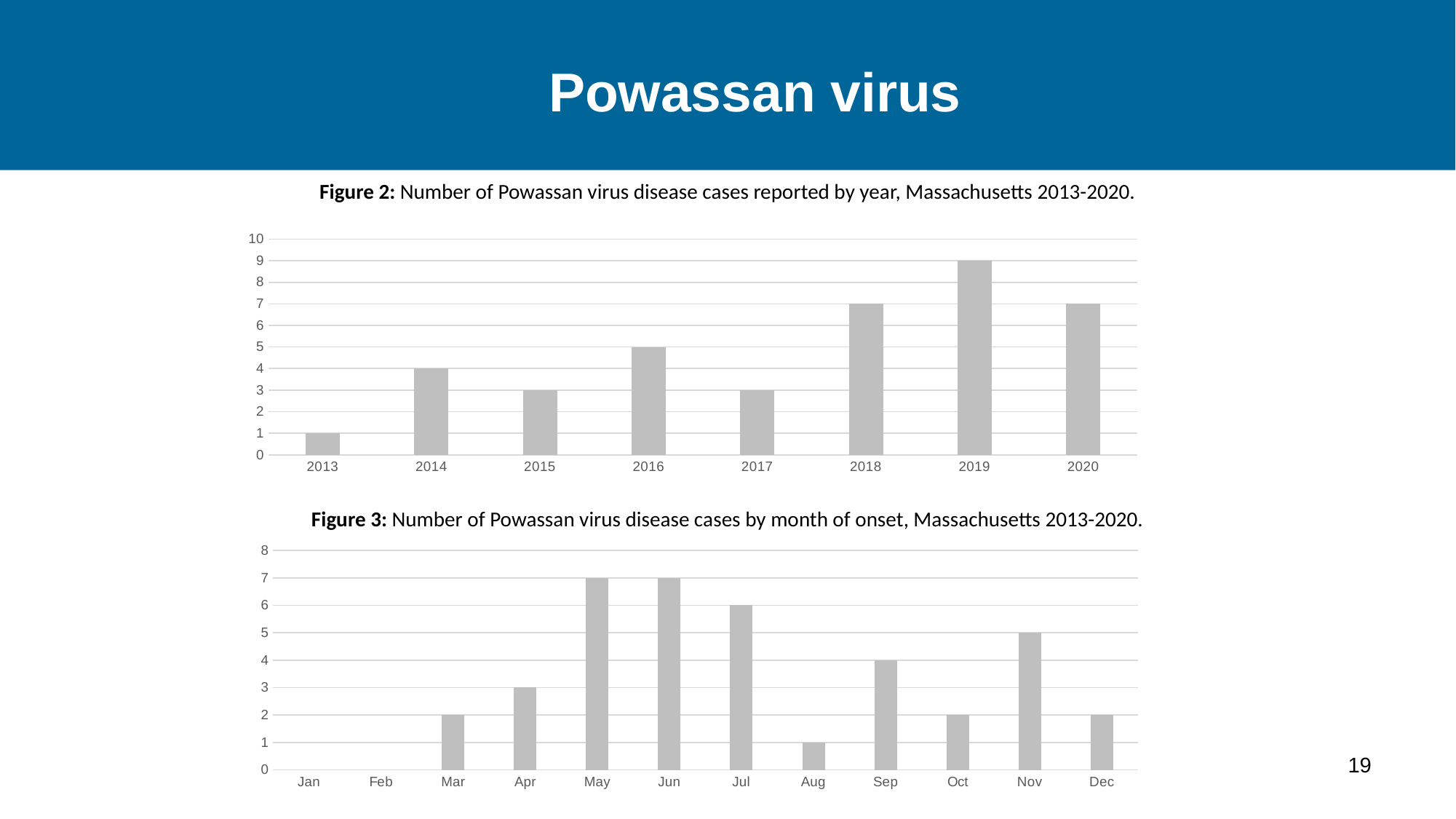
In Figure 3, what is the difference between the number of cases in May and in September? 3 In Figure 2, which year had the highest number of reported cases? 2019 In Figure 2, how many years are shown on the x axis? 8 In Figure 2, which year had the lowest number of reported cases? 2013 In Figure 2, which year had more reported cases, 2014 or 2018? 2018 In Figure 2, what is the difference between the number of cases in 2019 and in 2016? 4 In Figure 3, which month had more cases, November or April? Nov In Figure 3, how many months are shown on the x axis? 12 In Figure 3, how many cases had a month of onset in July? 6 In Figure 3, which month had the lowest non-zero number of cases? Aug In Figure 2, how many Powassan virus disease cases were reported in 2019? 9 What kind of chart is Figure 2? Bar chart